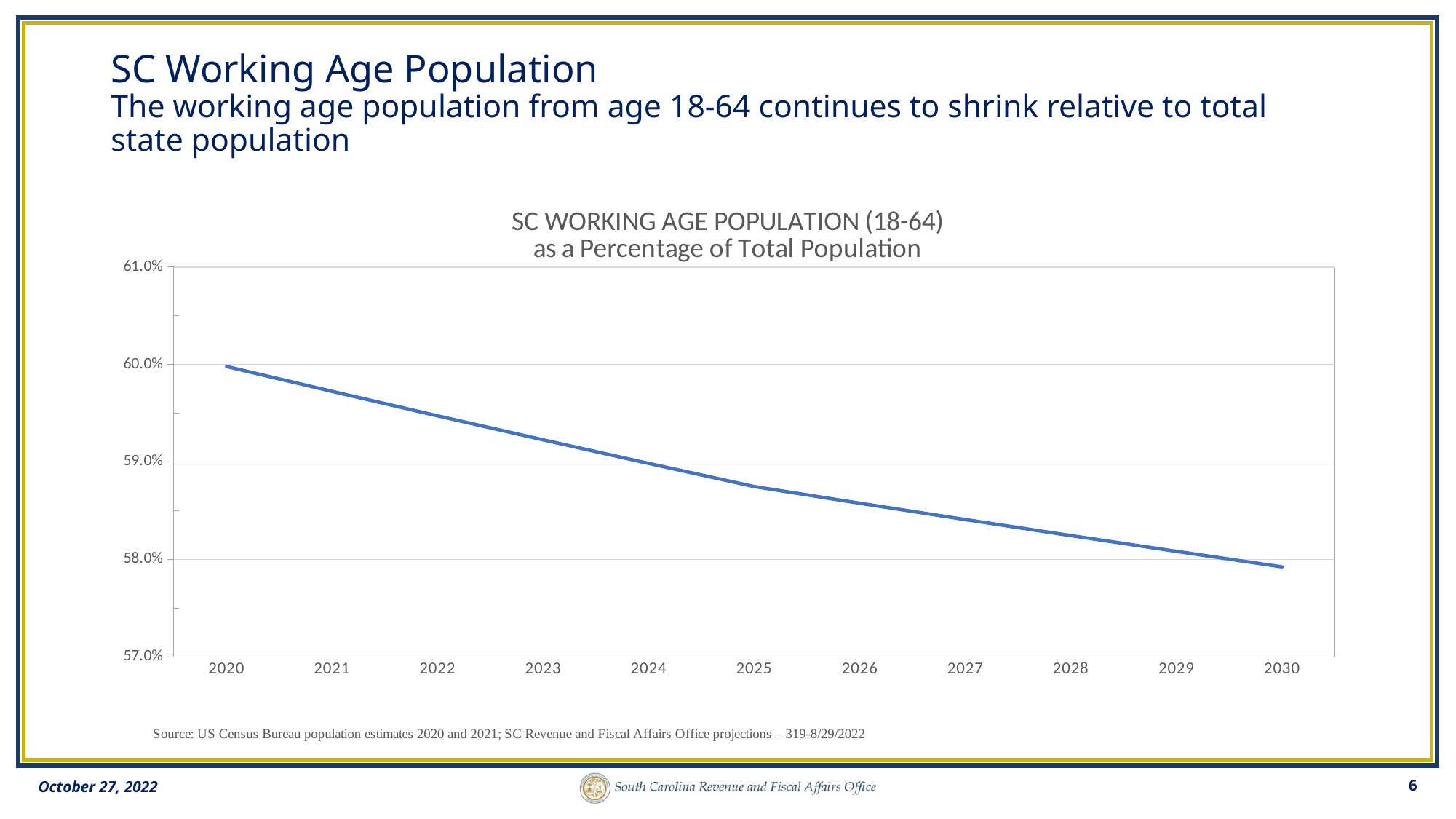
Which year has the highest working age population percentage? 2020 Does the working age population percentage rise or fall from 2020 to 2030? fall How many lines are plotted on the chart? 1 Which year has the lowest working age population percentage? 2030 Is the value for 2028 greater or less than 58.0%? greater Which year has a larger working age population percentage, 2022 or 2027? 2022 How many years are plotted along the x axis of the chart? 11 Is the value for 2025 greater or less than 59.0%? less Is the value for 2023 greater or less than 59.0%? greater What is the title of the chart? SC WORKING AGE POPULATION (18-64) as a Percentage of Total Population What kind of chart is shown on the slide? line chart